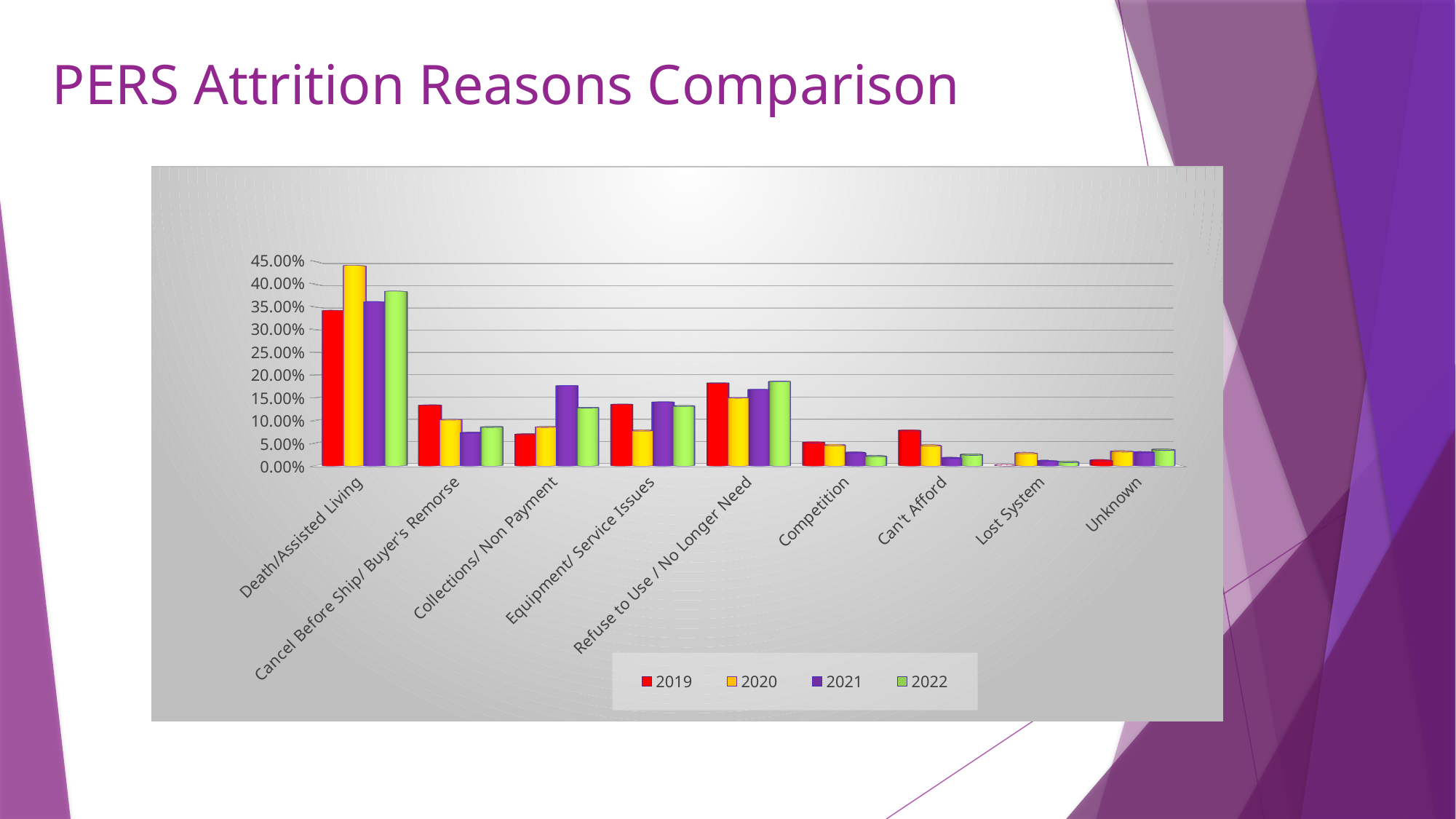
For Collections/ Non Payment, which year has the larger value, 2019 or 2021? 2021 For Cancel Before Ship/ Buyer's Remorse, which year has the larger value, 2019 or 2021? 2019 Which category has the highest value for 2020? Death/Assisted Living How many series does the legend list? 4 Is the 2019 value for Refuse to Use / No Longer Need greater or less than 15.00%? greater Is the 2019 value for Death/Assisted Living greater or less than 30.00%? greater Which years are listed in the legend? 2019, 2020, 2021, 2022 How many attrition reason categories are shown on the x axis? 9 Is the 2020 value for Death/Assisted Living greater or less than 40.00%? greater What kind of chart is shown on the slide? bar chart Which year has the lowest value for Lost System? 2019